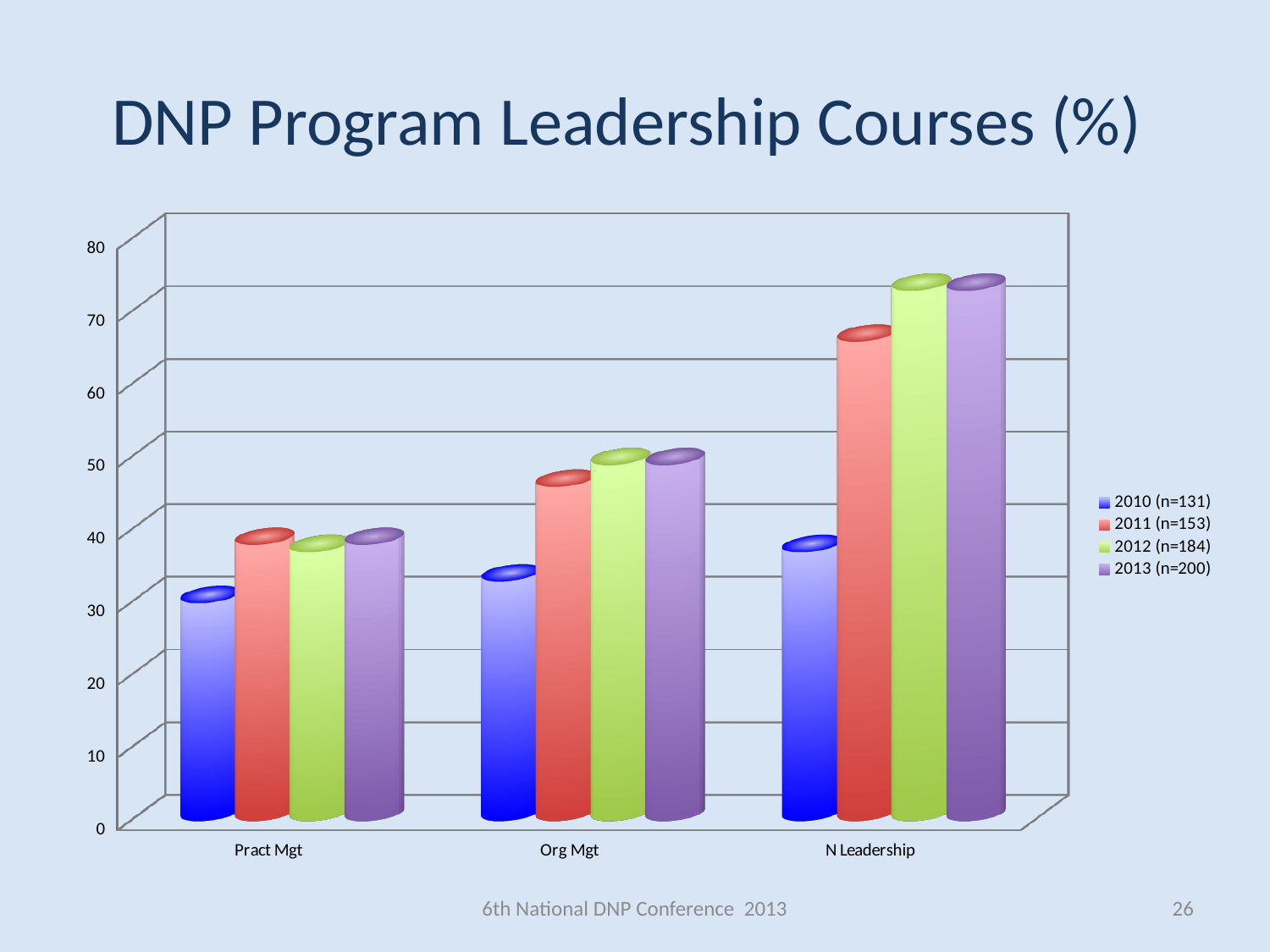
How many categories are shown on the x axis? 3 Is the value for 2010 (n=131) in Pract Mgt greater or less than 40? less Is the value for 2012 (n=184) in N Leadership greater or less than 70? greater Is the value for 2010 (n=131) in Org Mgt greater or less than 40? less What is the title of the chart? DNP Program Leadership Courses (%) How many series does the legend list? 4 What kind of chart is shown on the slide? bar chart Which category has the lowest value for the 2012 (n=184) series? Pract Mgt Do the values for the 2013 (n=200) series rise or fall from Pract Mgt to N Leadership? rise Which category has the highest value for the 2010 (n=131) series? N Leadership Which is larger in Org Mgt: the value for 2010 (n=131) or the value for 2011 (n=153)? 2011 (n=153)